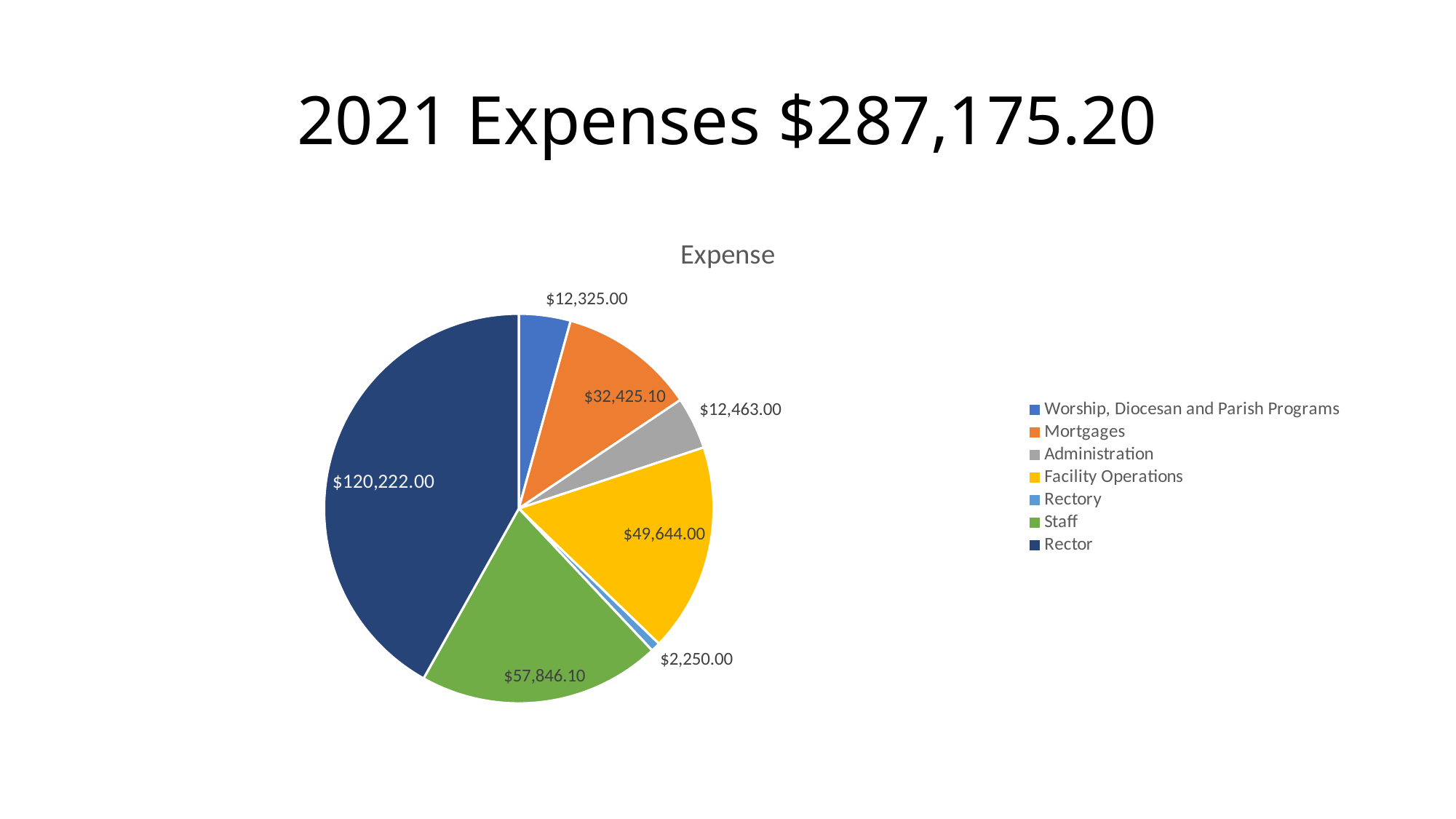
Which category has the smallest slice in the Expense pie chart? Rectory How many categories does the legend of the Expense pie chart list? 7 What is the value of the Facility Operations slice in the Expense pie chart? $49,644.00 What is the value of the Mortgages slice in the Expense pie chart? $32,425.10 What is the value of the Rector slice in the Expense pie chart? $120,222.00 Which is larger in the Expense pie chart, Staff or Facility Operations? Staff Which category has the largest slice in the Expense pie chart? Rector What type of chart is shown on the slide? pie chart What is the difference between the Rector and Staff values in the Expense pie chart? $62,375.90 What is the value of the Staff slice in the Expense pie chart? $57,846.10 What is the title of the pie chart on the slide? Expense What is the value of the Rectory slice in the Expense pie chart? $2,250.00